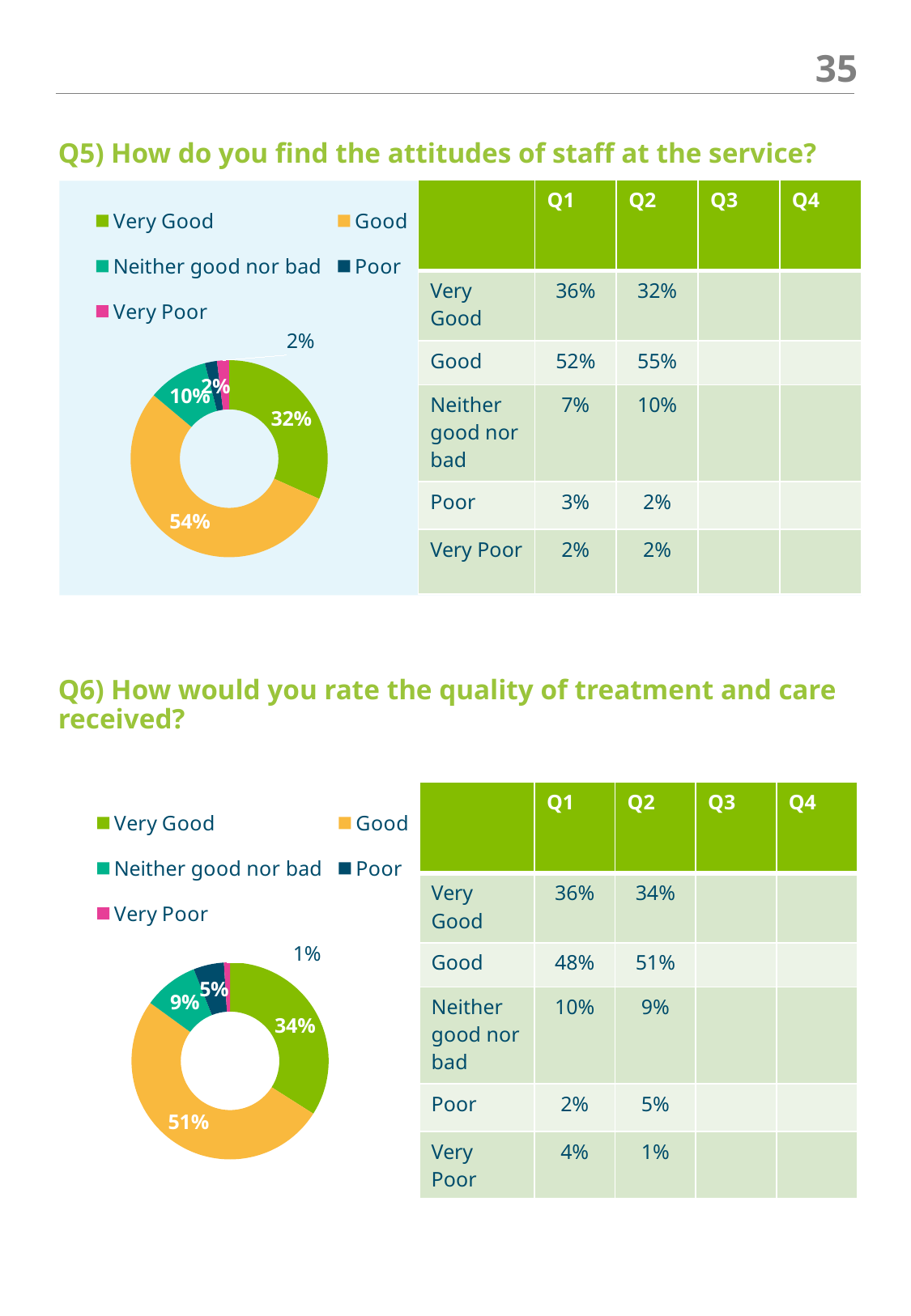
In the Q6 chart on quality of treatment and care, what colour represents the Good category? Orange In the Q6 chart on quality of treatment and care, which category has the smallest slice? Very Poor In the Q6 chart on quality of treatment and care, which is larger, the Neither good nor bad slice or the Poor slice? Neither good nor bad In the Q6 chart on quality of treatment and care, what percentage is shown for the Good slice? 51% In the Q5 chart on staff attitudes, what percentage is shown for the Good slice? 54% In the Q5 chart on staff attitudes, what percentage is shown for the Very Good slice? 32% In the Q5 chart on staff attitudes, what is the difference between the Good and Very Good slices? 22% In the Q5 chart on staff attitudes, which category has the largest slice? Good What kind of chart is used for Q5 on staff attitudes? Doughnut chart In the Q6 chart on quality of treatment and care, what percentage is shown for the Poor slice? 5% How many series does the legend of the Q5 chart on staff attitudes list? 5 In the Q6 chart on quality of treatment and care, what is the difference between the Very Good and Neither good nor bad slices? 25%